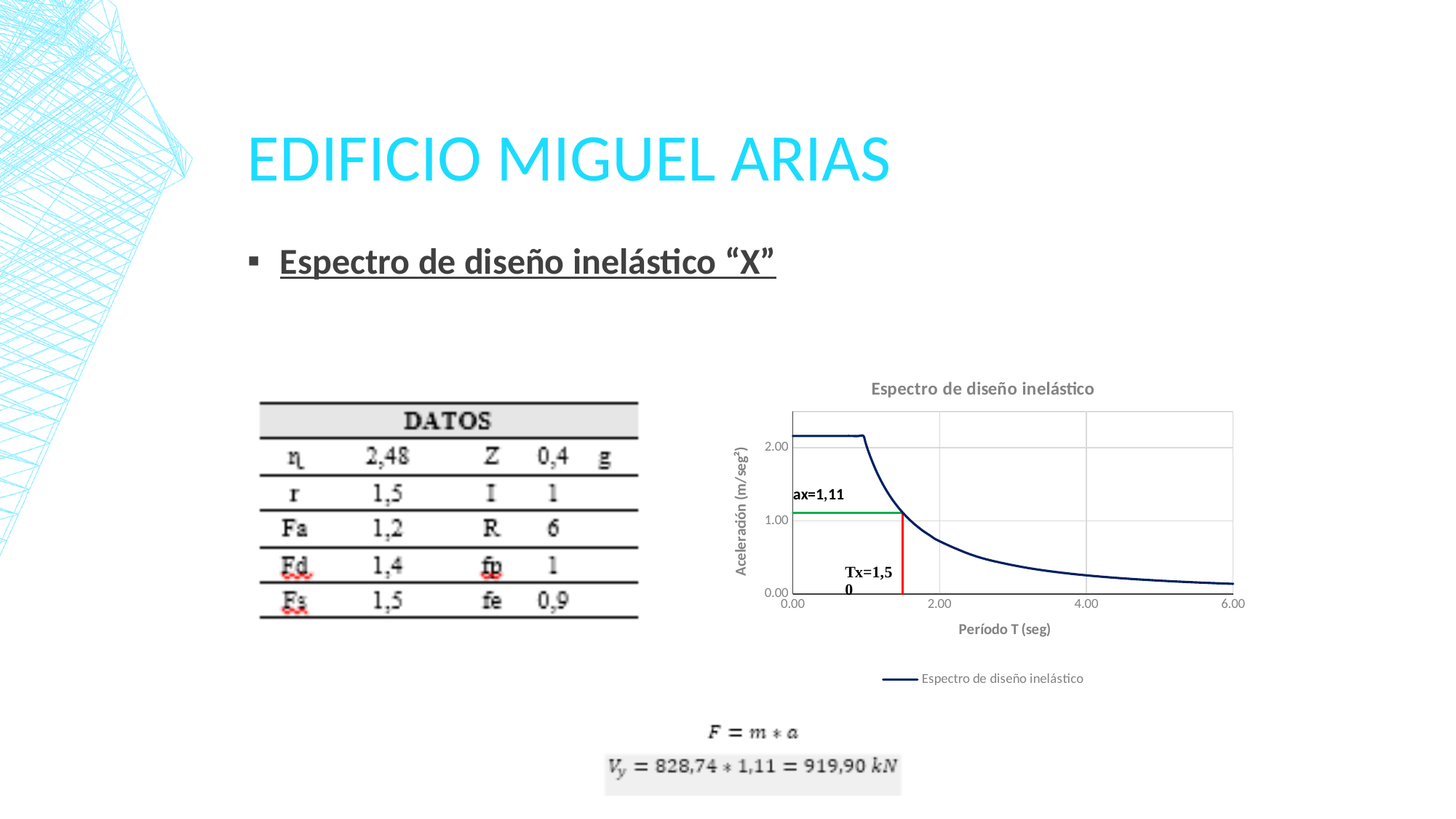
What kind of chart is shown on the slide? line chart What is the highest tick value shown on the x axis of the chart? 6.00 How many series does the chart legend list? 1 Is the acceleration value at a period of 4.00 seconds greater or less than 1.00? less What is the title of the chart? Espectro de diseño inelástico What is the label of the x axis of the chart? Período T (seg) Does the plotted acceleration rise or fall as the period increases beyond about 1 second? fall According to the annotation on the chart, what is the acceleration value ax at the marked period? ax=1,11 According to the annotation on the chart, at what period Tx is the acceleration ax=1,11 marked? Tx=1,50 Which is larger: the acceleration at a period of 0.00 seconds or at a period of 4.00 seconds? 0.00 seconds Is the acceleration value at a period of 0.00 seconds greater or less than 2.00? greater Is the acceleration value at a period of 6.00 seconds greater or less than 1.00? less